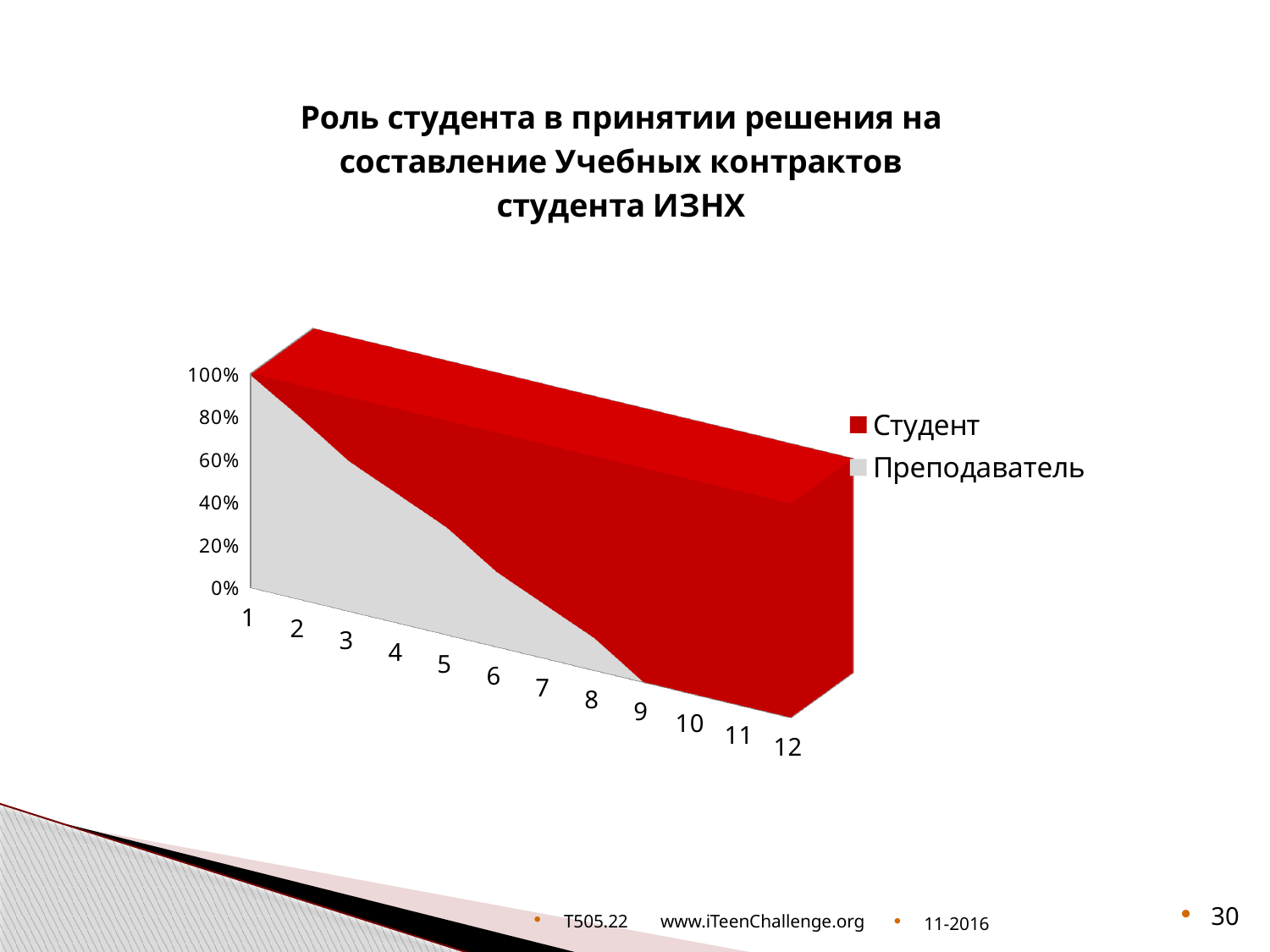
Which series is shown in grey? Преподаватель At category 1, which series has the larger share, Студент or Преподаватель? Преподаватель Is the value for Преподаватель at category 8 greater or less than 40%? less At category 11, which series has the larger share, Студент or Преподаватель? Студент What kind of chart is shown on the slide? area chart Is the value for Преподаватель at category 2 greater or less than 60%? greater What is the highest percentage shown on the y axis? 100% Which series is shown in red? Студент Does the share for Преподаватель rise or fall along the x axis from 1 to 12? fall How many series does the legend list? 2 Does the share for Студент rise or fall along the x axis from 1 to 12? rise How many categories are shown along the x axis? 12